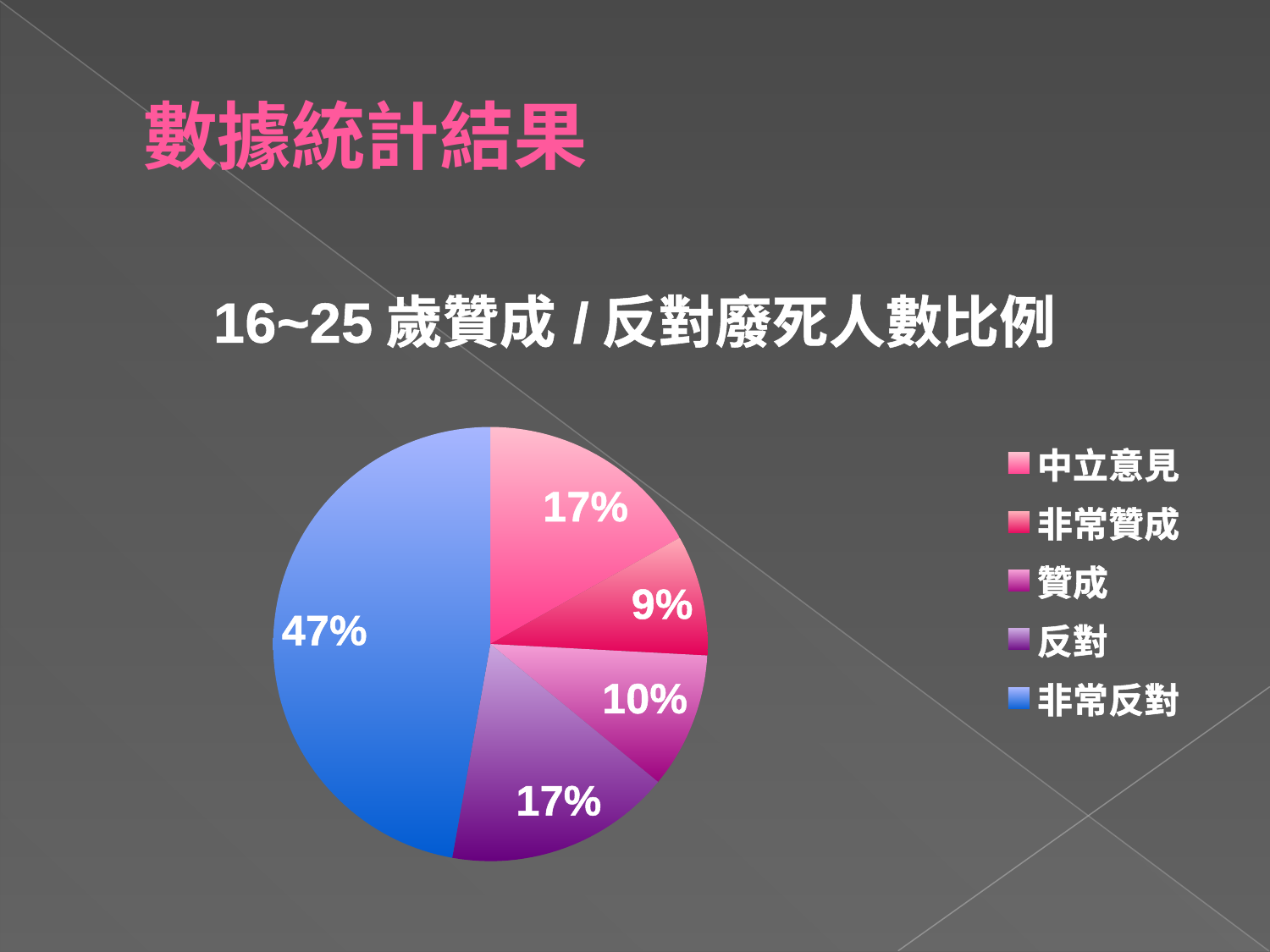
Which colour represents 非常反對 in the pie chart? blue What percentage of the pie is 贊成? 10% What is the difference in percentage points between 非常反對 and 反對? 30 What percentage of the pie is 非常贊成? 9% What percentage of the pie is 中立意見? 17% How many slices does the pie chart have? 5 What percentage of the pie is 非常反對? 47% What is the title of the chart? 16~25 歲贊成 / 反對廢死人數比例 Which category has the largest share of the pie? 非常反對 What kind of chart is shown on the slide? pie chart How many entries does the legend list? 5 Which category has the smallest share of the pie? 非常贊成